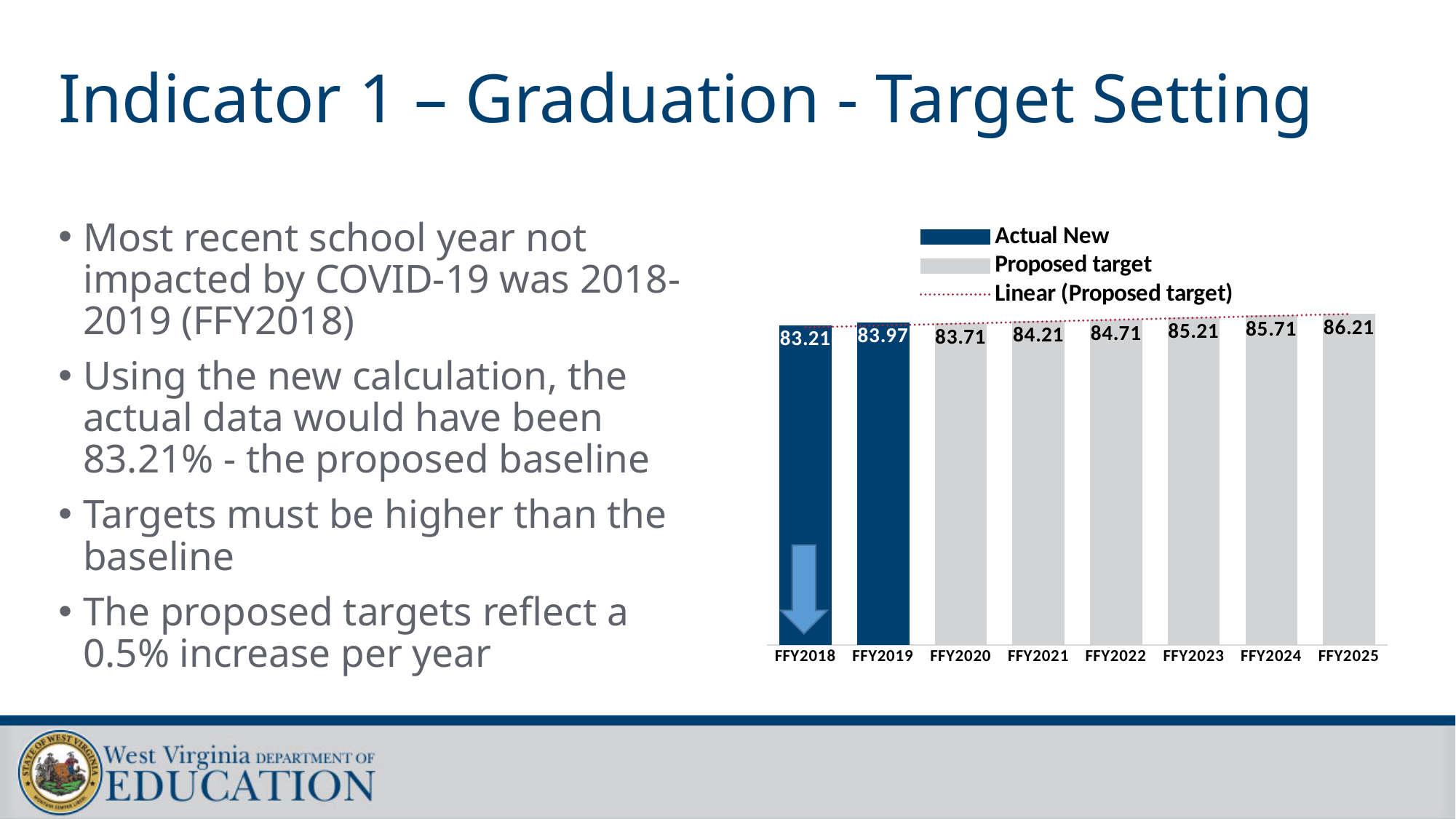
What is the value shown for FFY2019? 83.97 Which is larger, the value for FFY2019 or the value for FFY2020? FFY2019 What is the difference between the FFY2025 value and the FFY2018 value? 3 Which year has the highest value on the chart? FFY2025 What is the value shown for FFY2018? 83.21 Which year has the lowest value on the chart? FFY2018 What type of chart is shown on the slide? Bar chart What is the difference between the FFY2019 value and the FFY2020 value? 0.26 What is the proposed target for FFY2025? 86.21 How many entries does the chart legend list? 3 What is the proposed target for FFY2022? 84.71 How many years are shown on the x axis of the chart? 8